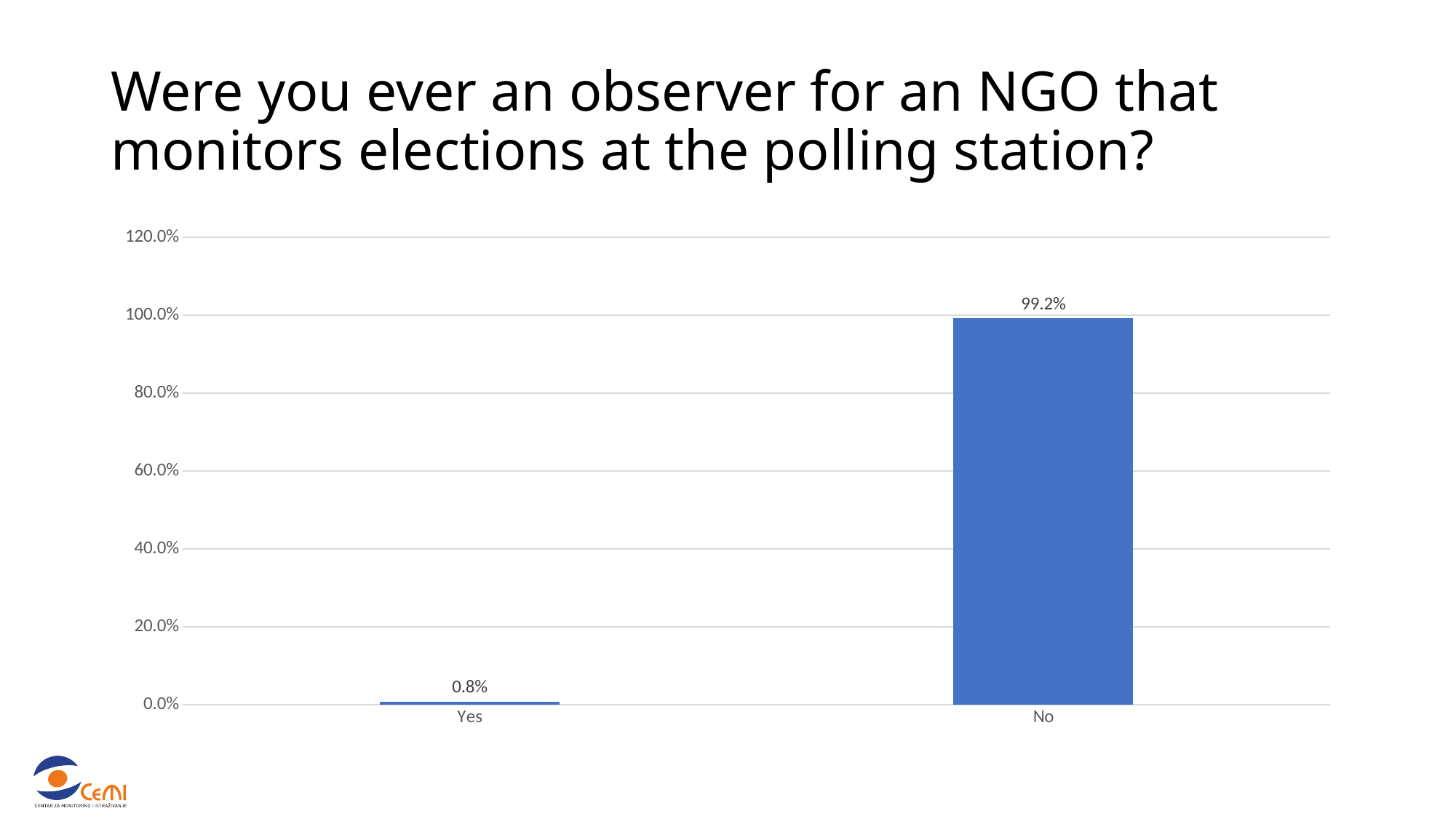
Which category has the lowest value? Yes What is the difference between the "No" and "Yes" values? 98.4% What kind of chart is shown on the slide? Bar chart What is the total of the "Yes" and "No" values? 100.0% Is the value for "No" greater or less than 80.0%? greater What percentage of respondents answered "Yes"? 0.8% What percentage of respondents answered "No"? 99.2% Is the value for "Yes" greater or less than 20.0%? less Which category has the highest value? No What is the highest value shown on the vertical axis? 120.0% How many categories are shown on the x axis? 2 Which is larger, the value for "Yes" or the value for "No"? No